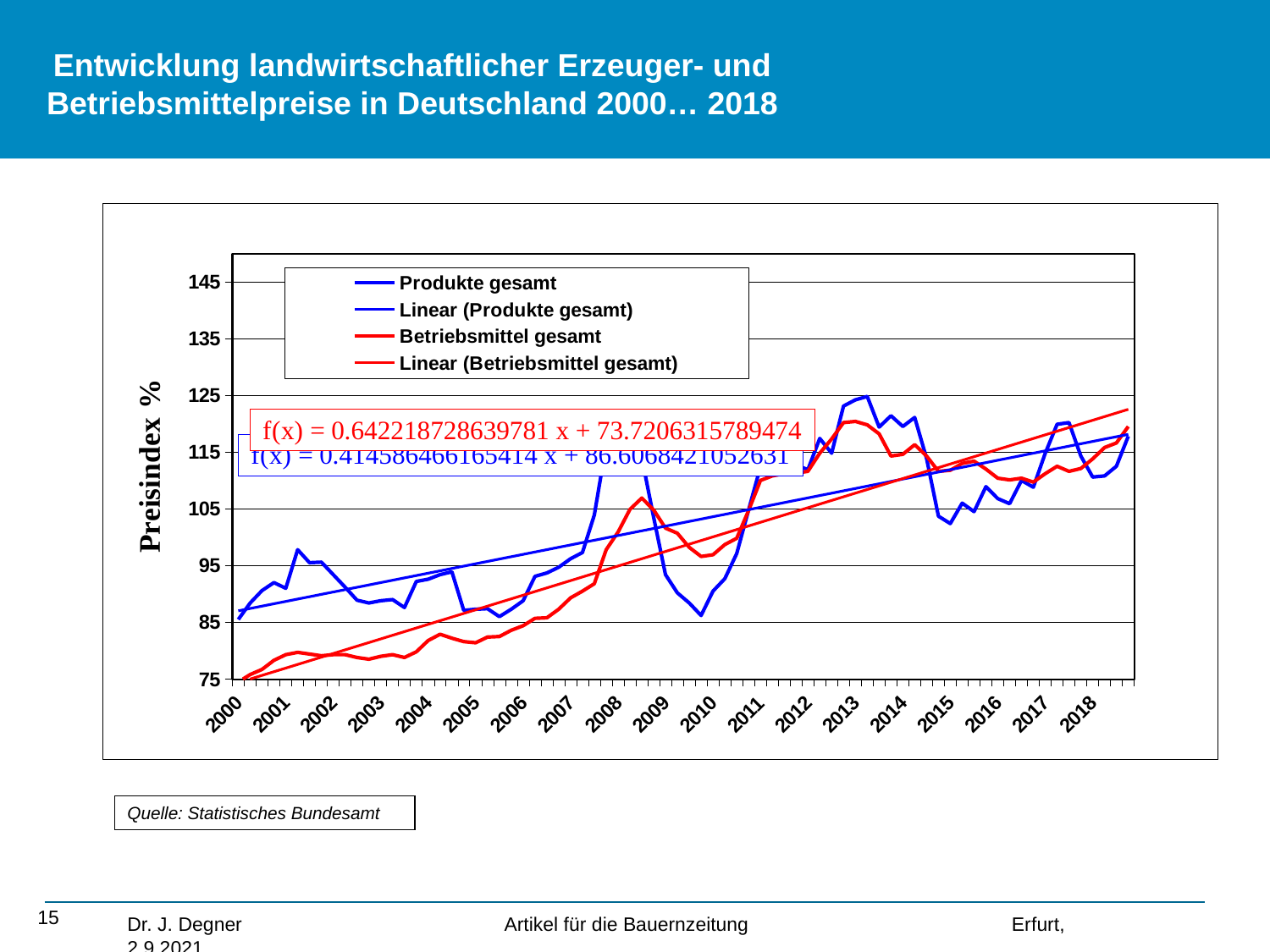
Does the Betriebsmittel gesamt series rise or fall overall from 2000 to 2018? Rise What is the label on the vertical axis of the chart? Preisindex % Is the value for Betriebsmittel gesamt in 2004 greater or less than 85? less How many year labels are shown along the x axis? 19 Does the Produkte gesamt series rise or fall overall from 2000 to 2018? Rise How many entries does the chart legend list? 4 In 2010, which series has the higher value, Produkte gesamt or Betriebsmittel gesamt? Betriebsmittel gesamt What is the title of the slide containing the chart? Entwicklung landwirtschaftlicher Erzeuger- und Betriebsmittelpreise in Deutschland 2000… 2018 What is the equation of the red linear trend line shown on the chart? f(x) = 0.642218728639781 x + 73.7206315789474 Is the peak value for Produkte gesamt around 2013 greater or less than 115? greater What kind of chart is shown on the slide? Line chart Is the value for Produkte gesamt in 2010 greater or less than 95? less